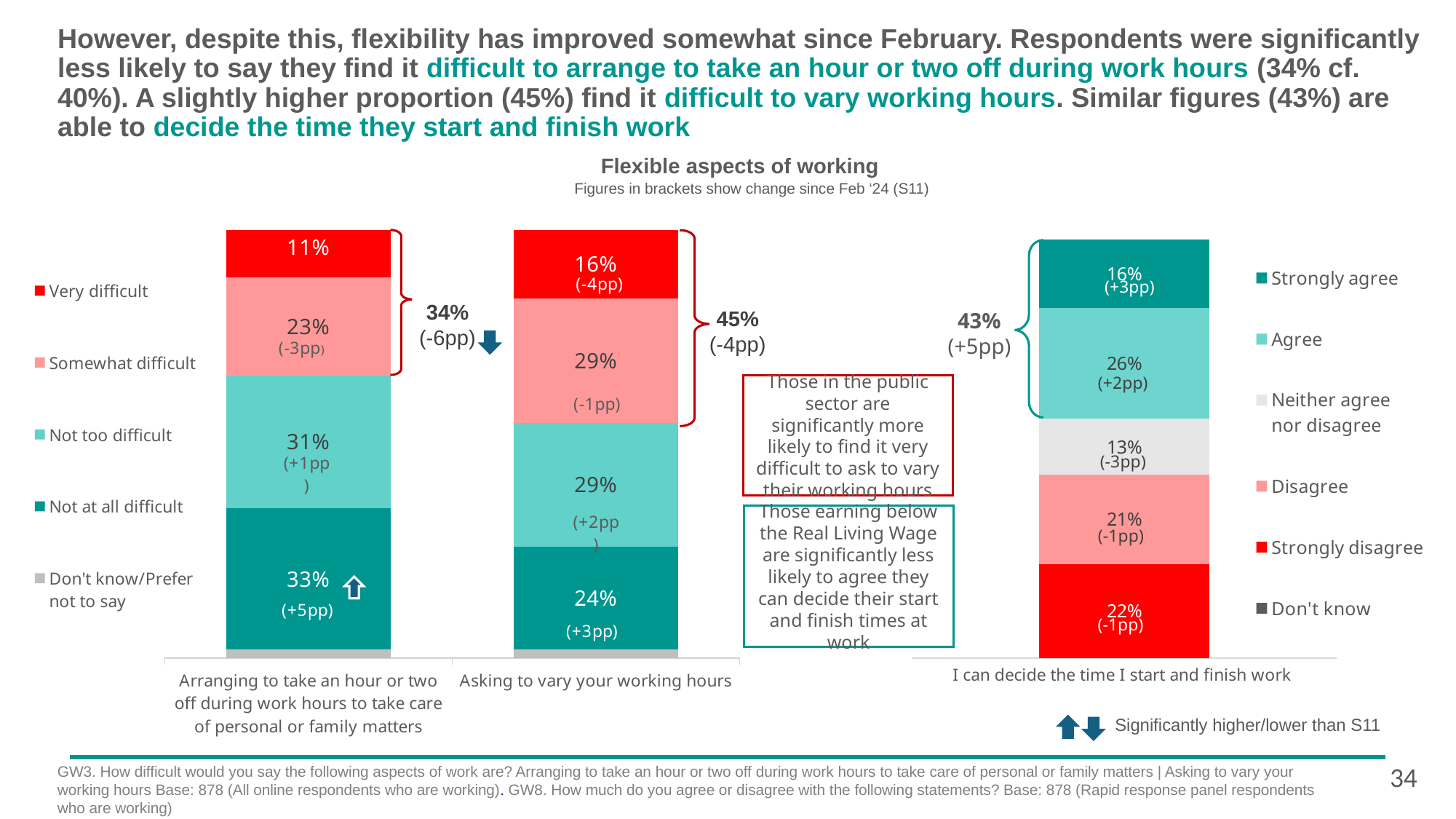
In the left chart, which category has the larger 'Somewhat difficult' share: 'Arranging to take an hour or two off during work hours' or 'Asking to vary your working hours'? Asking to vary your working hours How many entries does the legend of the left chart list? 5 In the left chart, what is the difference in the 'Not too difficult' share between 'Arranging to take an hour or two off' (31%) and 'Asking to vary your working hours' (29%)? 2 percentage points In the left chart, what is the combined share of 'Very difficult' and 'Somewhat difficult' for 'Asking to vary your working hours'? 45% What type of chart is used on this slide? Stacked bar chart In the right chart ('I can decide the time I start and finish work'), what percentage 'Strongly agree'? 16% How many entries does the legend of the right chart list? 6 In the left chart, what percentage of respondents said it is 'Very difficult' to arrange to take an hour or two off during work hours? 11% In the left chart, what percentage said it is 'Not at all difficult' when asking to vary their working hours? 24% In the right chart, which response option has the largest share? Agree In the right chart, what percentage 'Neither agree nor disagree' that they can decide the time they start and finish work? 13% What is the title of the chart on this slide? Flexible aspects of working